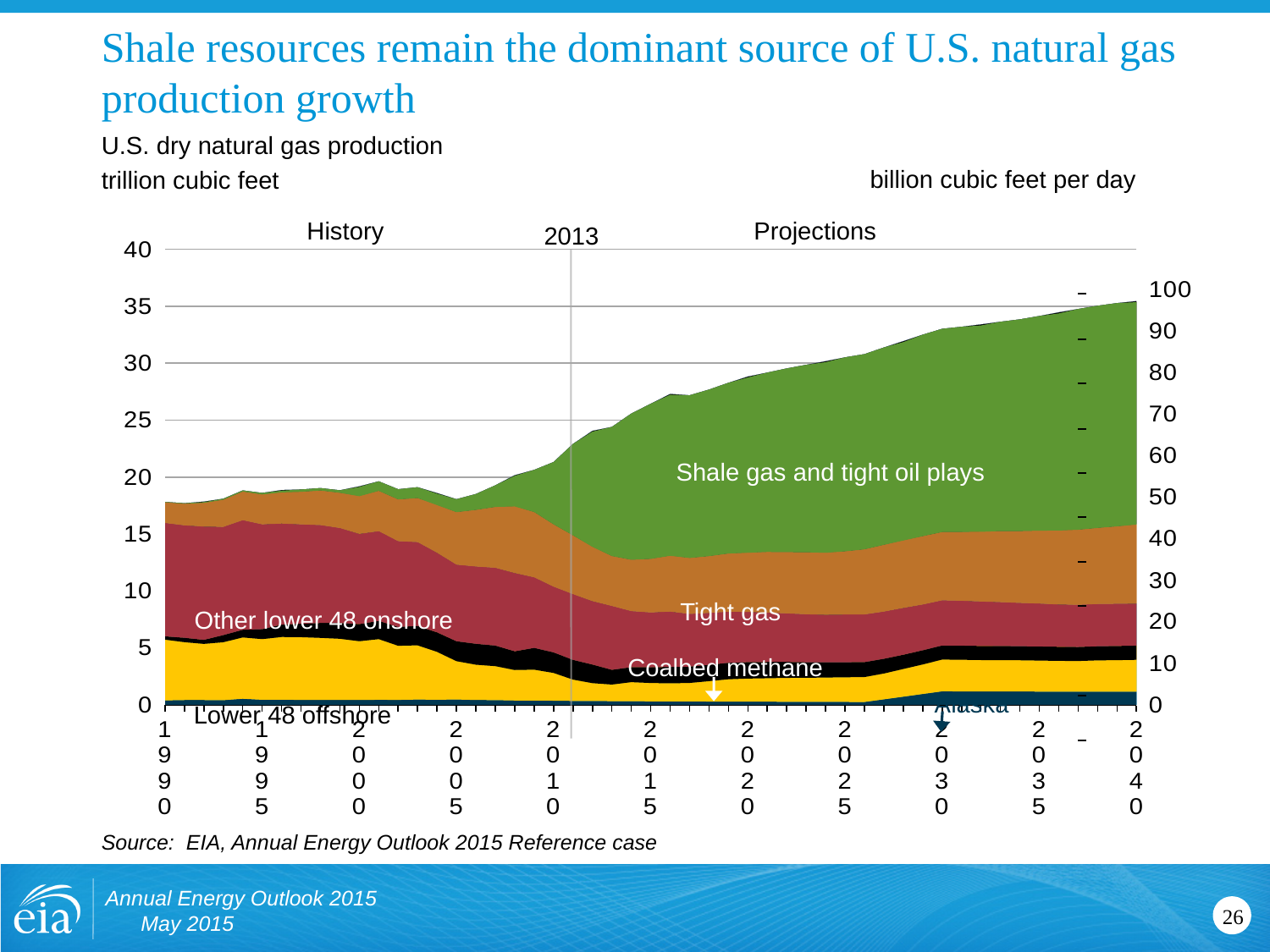
What is the title of the chart? U.S. dry natural gas production Is total production in 2040 greater or less than 30 trillion cubic feet? greater Does total U.S. dry natural gas production rise or fall from 2013 to 2040? rise Is total production in 2020 greater or less than 25 trillion cubic feet? greater Which production source is the largest in 2040? Shale gas and tight oil plays Which year separates the History and Projections sections of the chart? 2013 Is total production in 2030 greater or less than 30 trillion cubic feet? greater How many production source categories are labeled in the chart? 6 In 2040, which is larger: production from shale gas and tight oil plays or from tight gas? Shale gas and tight oil plays What kind of chart is shown on the slide? stacked area chart What unit is shown on the left axis of the chart? trillion cubic feet